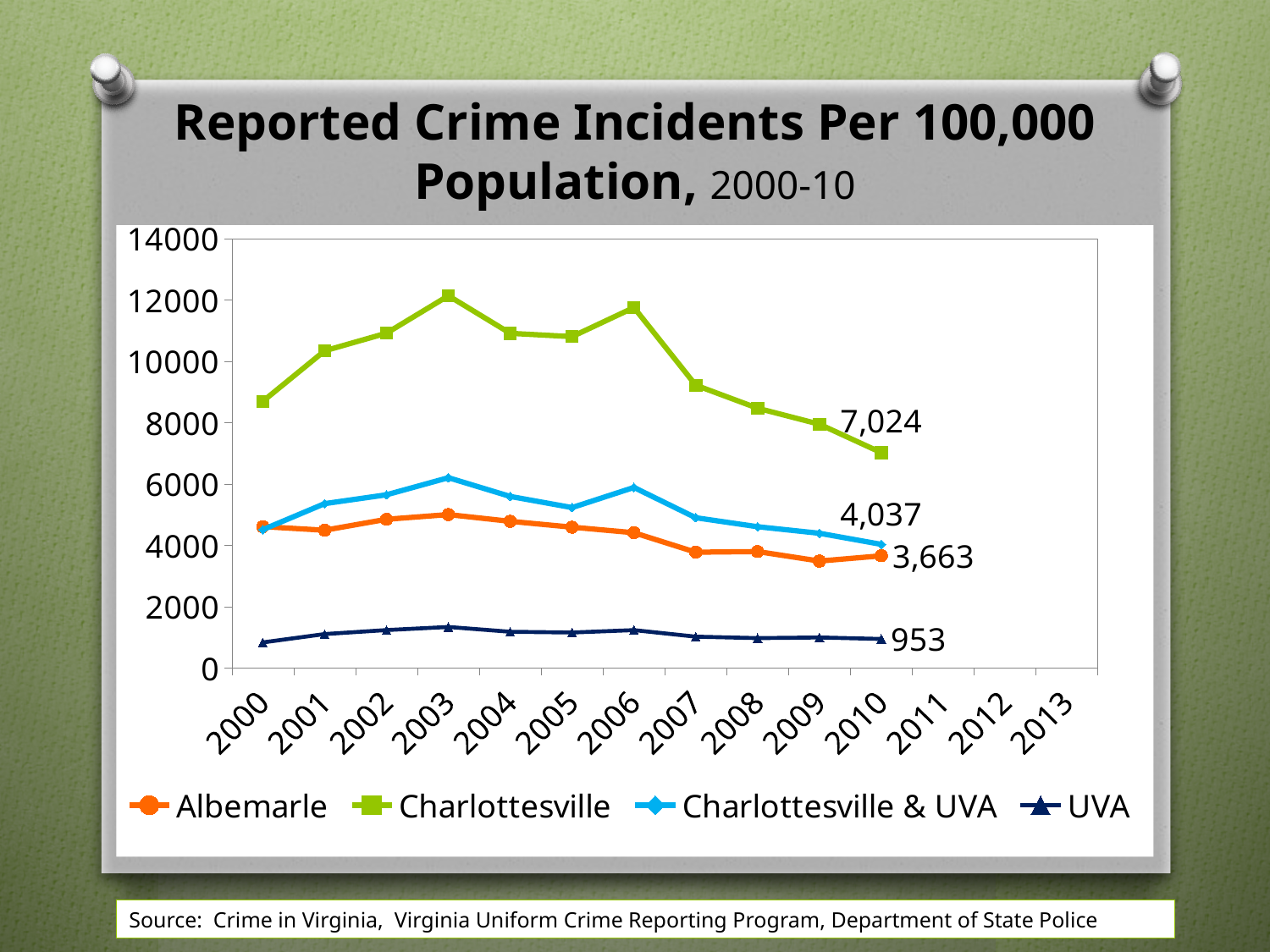
What is the value for Albemarle in 2010? 3,663 What is the value for Charlottesville in 2010? 7,024 What is the value for UVA in 2010? 953 Is the value for Charlottesville in 2006 greater or less than 10000? greater What is the difference between the Charlottesville and Albemarle values in 2010? 3,361 Which series has the lowest value in 2010? UVA What is the value for Charlottesville & UVA in 2010? 4,037 Does the Charlottesville line rise or fall from 2006 to 2010? fall Which series has the highest value in 2010? Charlottesville Is the value for Charlottesville in 2000 greater or less than 10000? less What kind of chart is shown on the slide? line chart How many series does the legend list? 4